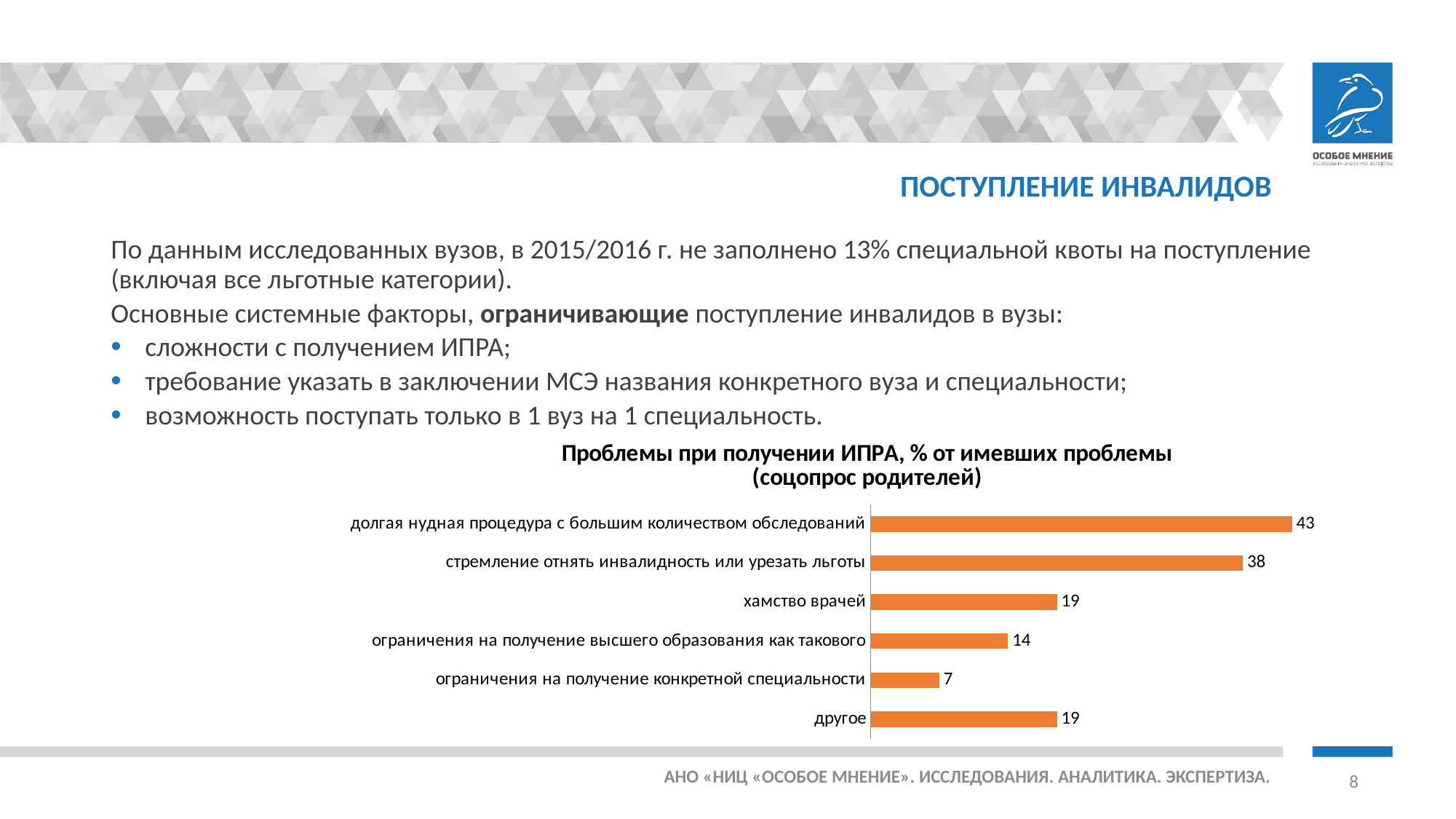
What value is shown for "стремление отнять инвалидность или урезать льготы"? 38 What value is shown for "долгая нудная процедура с большим количеством обследований"? 43 Which category has the highest value? долгая нудная процедура с большим количеством обследований Which category has the lowest value? ограничения на получение конкретной специальности What value is shown for "ограничения на получение конкретной специальности"? 7 What is the title of the chart? Проблемы при получении ИПРА, % от имевших проблемы (соцопрос родителей) What kind of chart is shown on the slide? bar chart Which is larger: the value for "ограничения на получение высшего образования как такового" or for "ограничения на получение конкретной специальности"? ограничения на получение высшего образования как такового How many categories are shown in the chart? 6 What value is shown for "хамство врачей"? 19 What colour are the bars in the chart? orange What is the difference between the values for "долгая нудная процедура с большим количеством обследований" and "стремление отнять инвалидность или урезать льготы"? 5